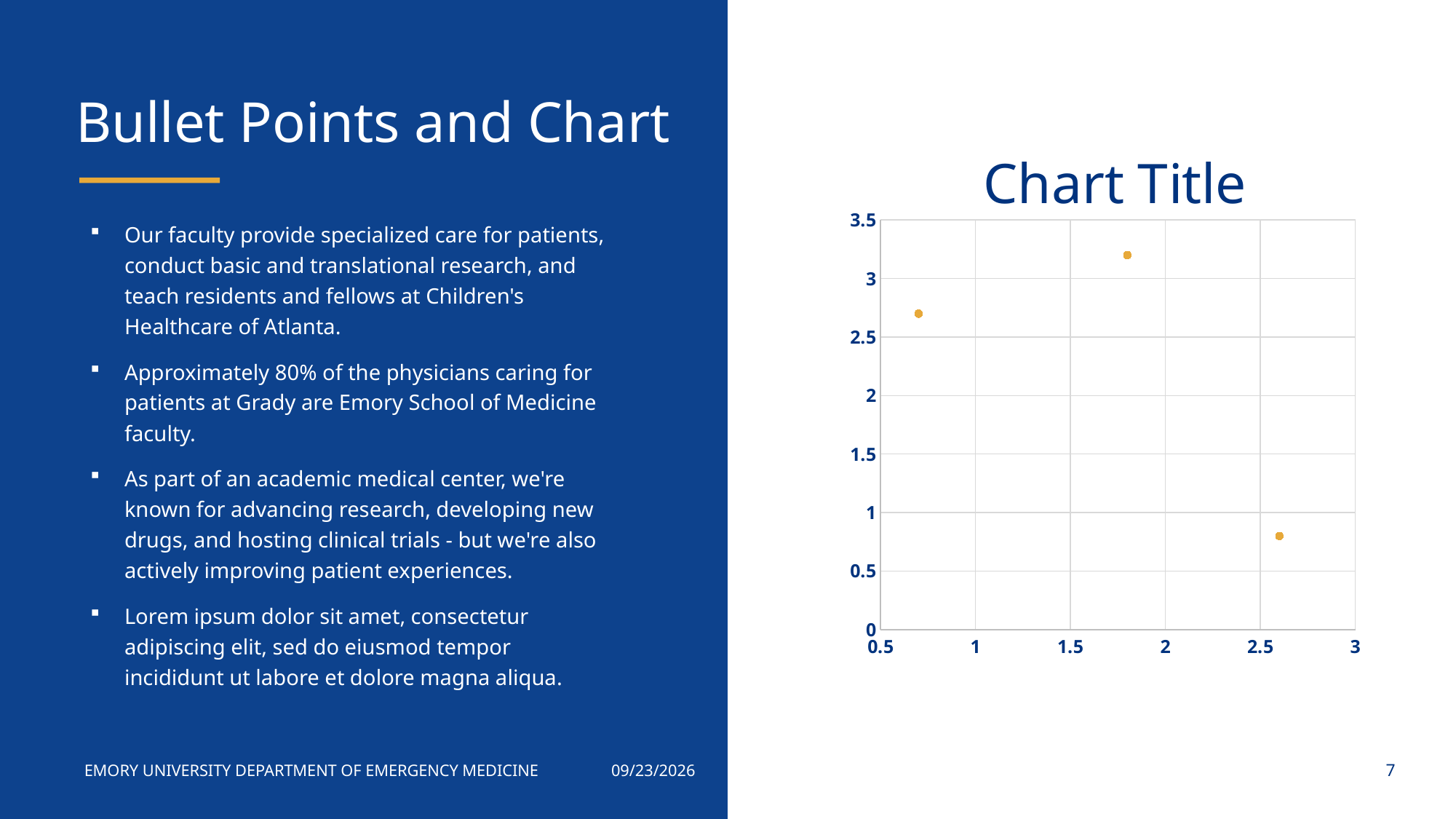
How many data points are plotted on the chart? 3 Which point has the highest y value: the leftmost, middle, or rightmost point? middle What kind of chart is shown on the slide? scatter chart Is the y value of the rightmost point greater or less than 1? less Which has the larger y value, the leftmost point or the rightmost point? leftmost point Is the y value of the middle point greater or less than 3? greater Which point has the lowest y value: the leftmost, middle, or rightmost point? rightmost What is the title of the chart? Chart Title Is the x value of the rightmost point greater or less than 2.5? greater What is the maximum value shown on the vertical axis? 3.5